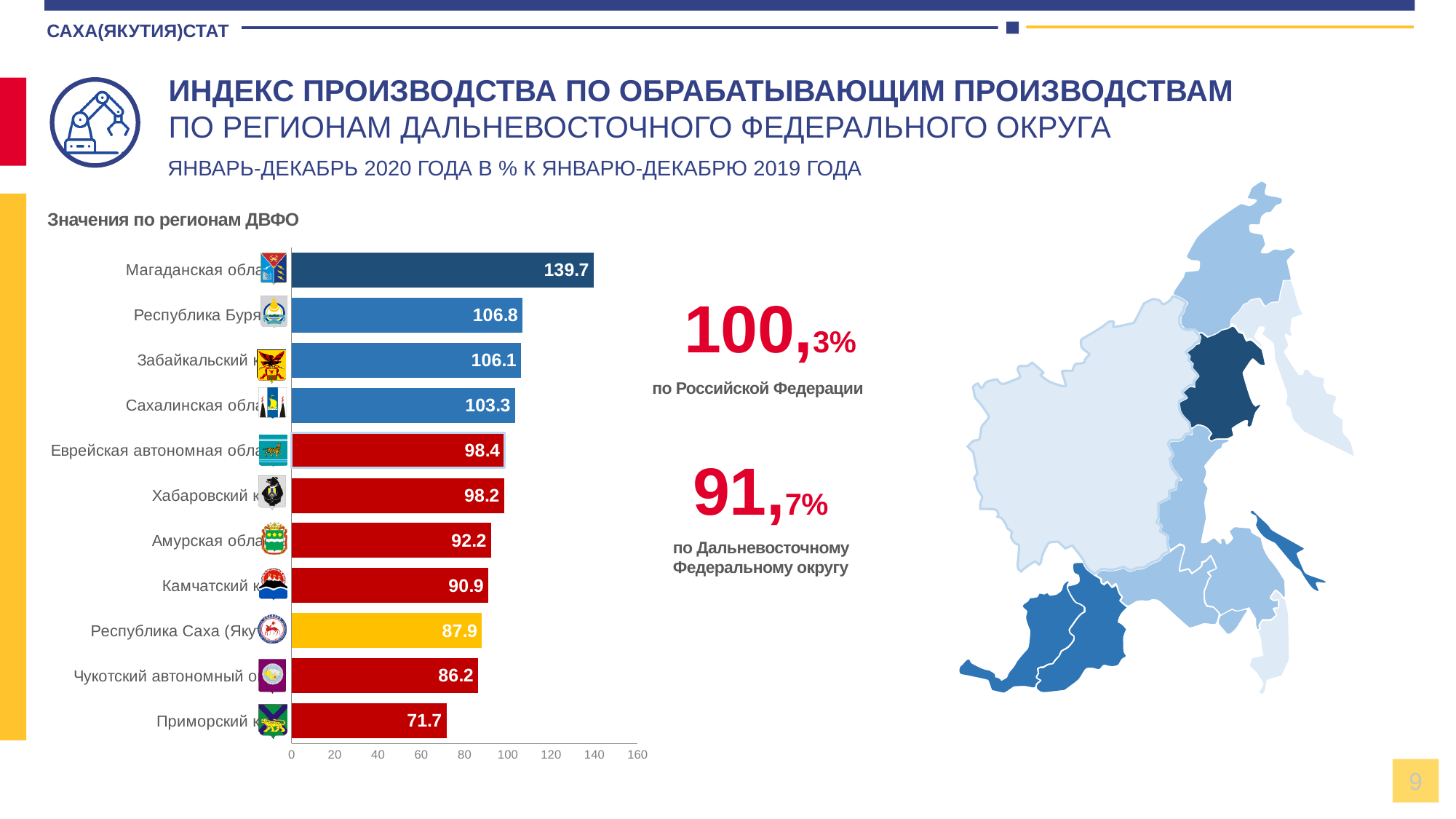
What is the difference between the values for Магаданская область and Приморский край? 68.0 What is the value for Хабаровский край? 98.2 What kind of chart is shown on the slide? bar chart Which is larger, the value for Амурская область or the value for Камчатский край? Амурская область Which region has the highest value in the chart? Магаданская область What is the value for Республика Саха (Якутия)? 87.9 Which region has the lowest value in the chart? Приморский край What is the value for Магаданская область? 139.7 Which region's bar is coloured yellow in the chart? Республика Саха (Якутия) Is the value for Чукотский автономный округ greater or less than 100? less How many regions are shown in the bar chart? 11 What is the value for Сахалинская область? 103.3